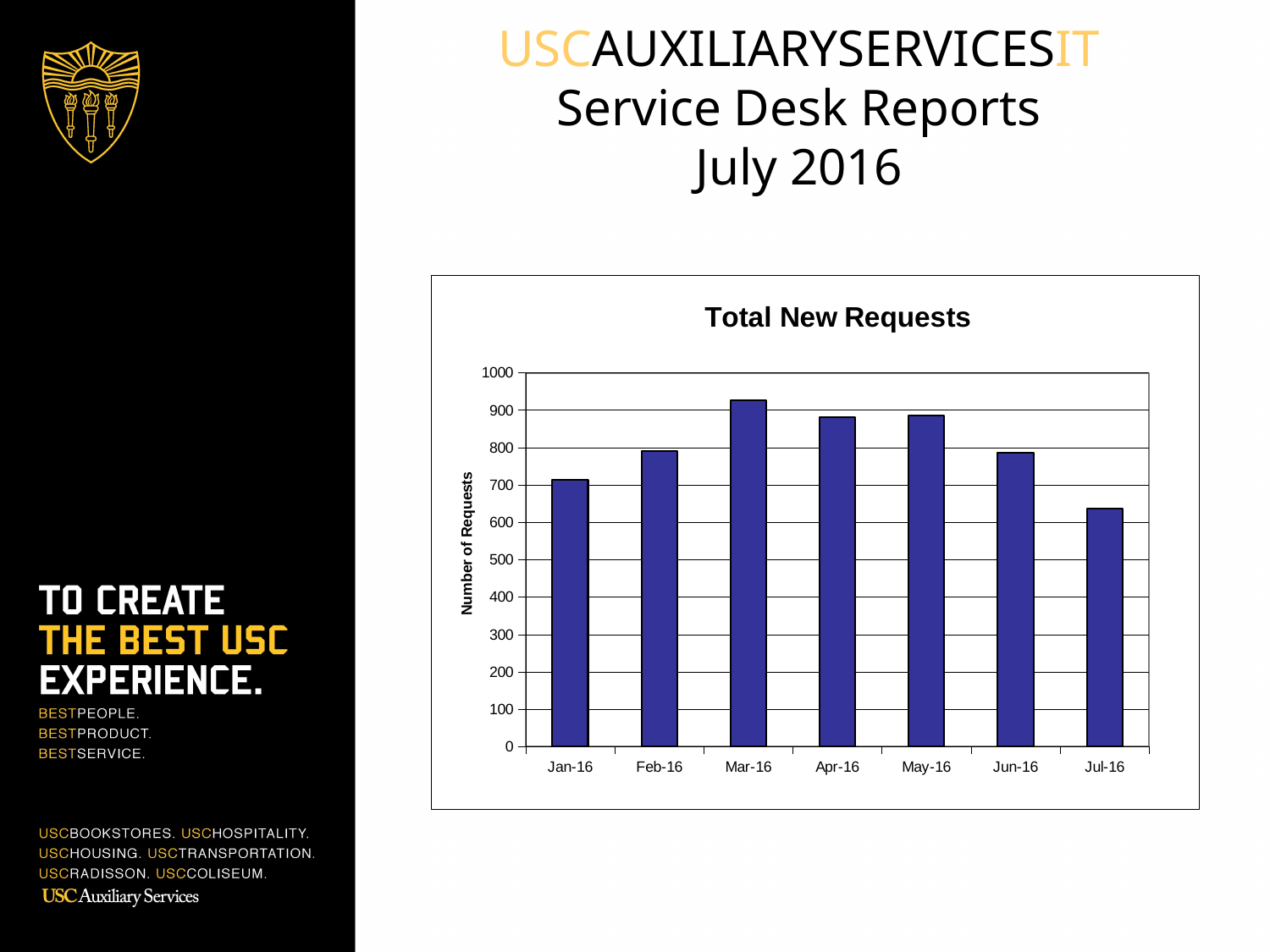
Which month has more total new requests, Feb-16 or Jul-16? Feb-16 What type of chart is shown on the slide? bar chart Is the value for Jul-16 greater or less than 700? less Is the value for Jan-16 greater or less than 800? less Is the value for Apr-16 greater or less than 800? greater How many months are shown on the x axis of the chart? 7 Do the values rise or fall from May-16 to Jul-16? fall What is the label on the vertical axis of the chart? Number of Requests Which month has the lowest number of total new requests? Jul-16 What is the title of the chart? Total New Requests Which month has the highest number of total new requests? Mar-16